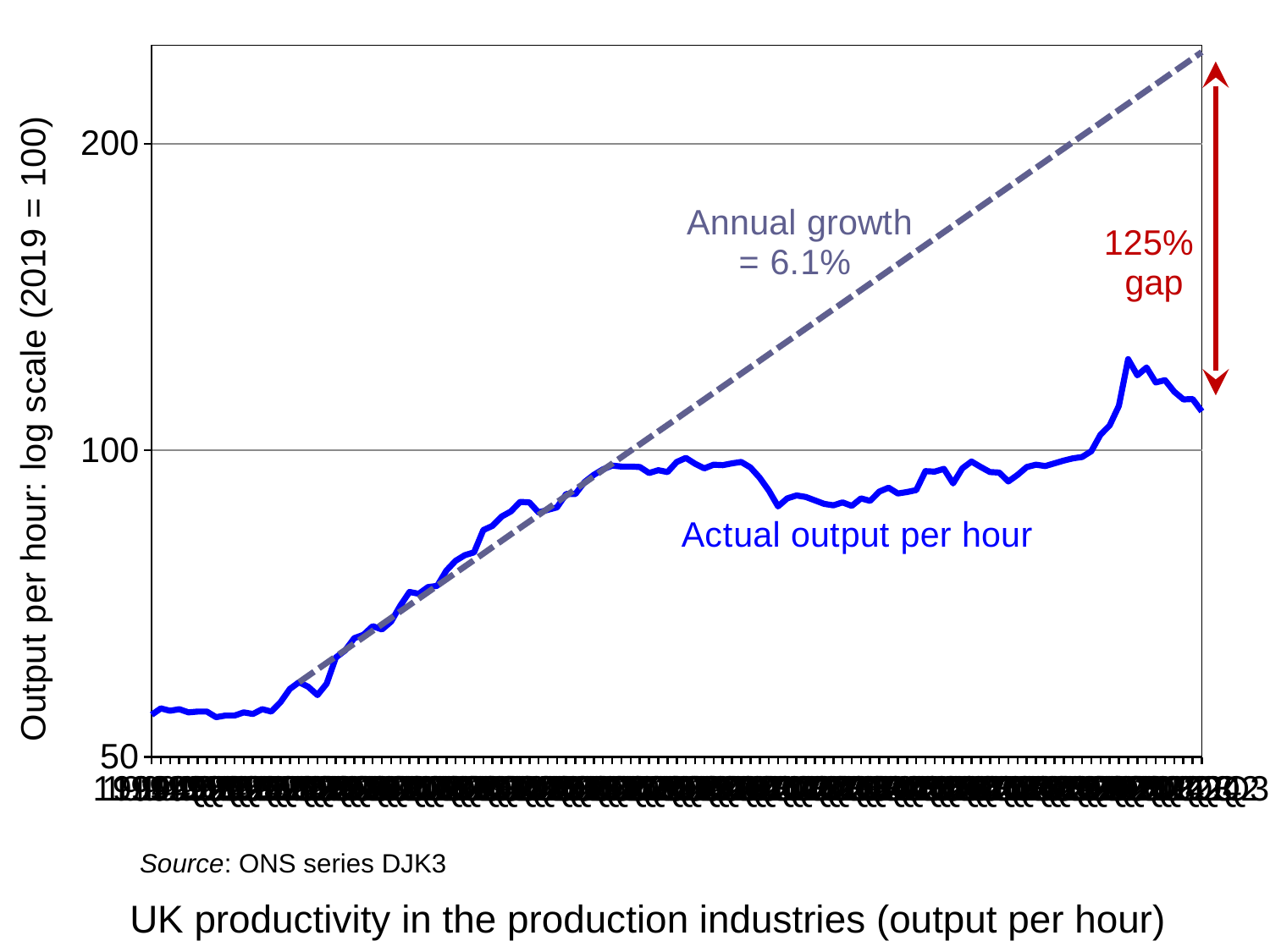
What is the title of the chart? UK productivity in the production industries (output per hour) How many data series are plotted on the chart? 2 What annual growth rate is shown for the dashed trend line? 6.1% At the right end of the chart, which is higher: the dashed trend line or the actual output per hour line? the dashed trend line Is the actual output per hour at the left end of the chart greater or less than 100? less Overall, does the actual output per hour line rise or fall from left to right? rise Is the actual output per hour at the right end of the chart greater or less than 100? greater Is the dashed trend line at the right end of the chart greater or less than 200? greater What is the size of the gap annotated between the trend line and actual output per hour at the right end of the chart? 125% What source is cited for the chart data? ONS series DJK3 What kind of chart is shown on the slide? line chart